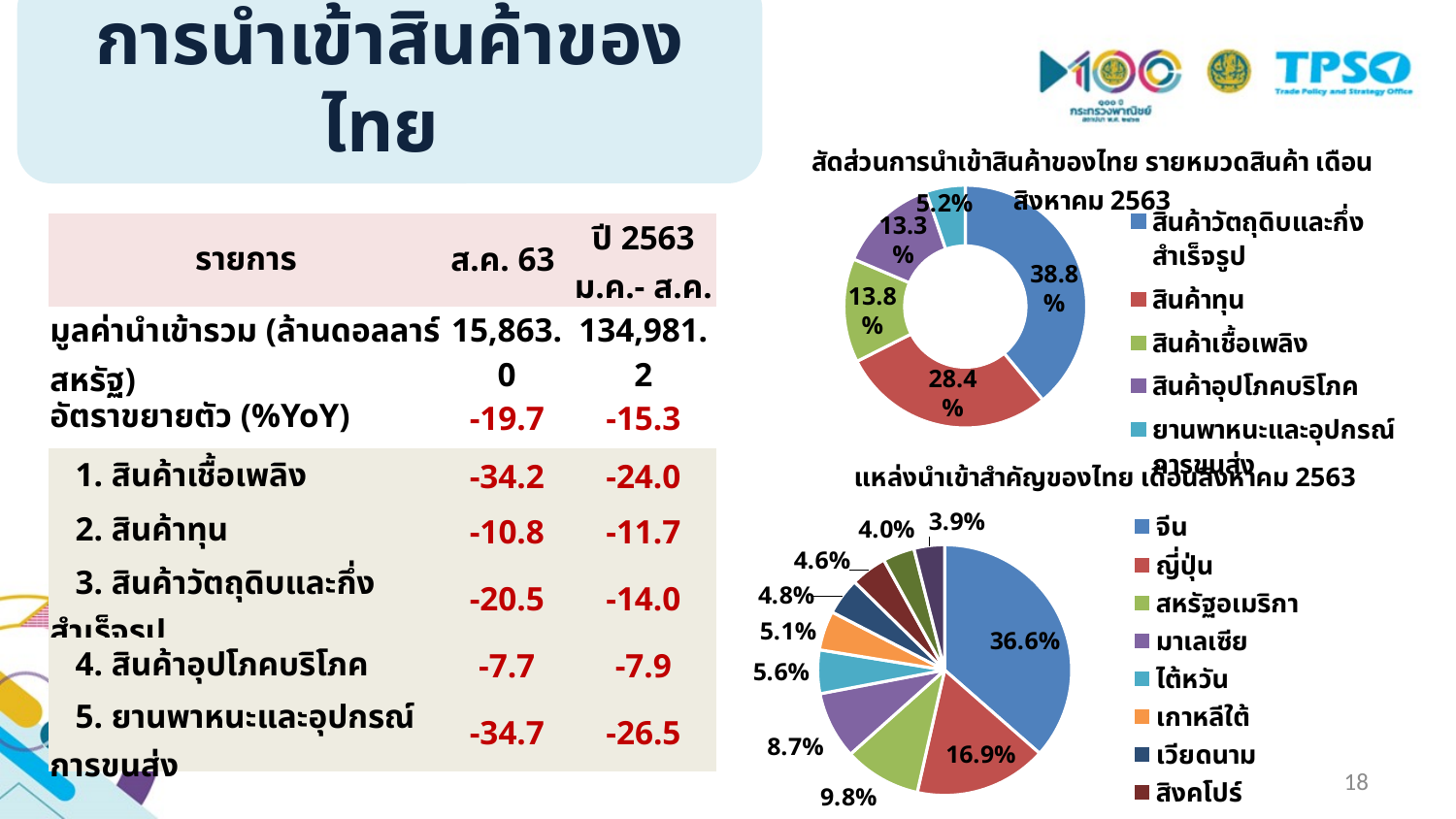
In the doughnut chart titled สัดส่วนการนำเข้าสินค้าของไทย รายหมวดสินค้า เดือนสิงหาคม 2563, which category has the largest share? สินค้าวัตถุดิบและกึ่งสำเร็จรูป In the doughnut chart titled สัดส่วนการนำเข้าสินค้าของไทย รายหมวดสินค้า เดือนสิงหาคม 2563, what is the difference in percentage points between สินค้าวัตถุดิบและกึ่งสำเร็จรูป and สินค้าทุน? 10.4 In the pie chart titled แหล่งนำเข้าสำคัญของไทย เดือนสิงหาคม 2563, which source has the largest share? จีน In the pie chart titled แหล่งนำเข้าสำคัญของไทย เดือนสิงหาคม 2563, what share does จีน have? 36.6% In the doughnut chart titled สัดส่วนการนำเข้าสินค้าของไทย รายหมวดสินค้า เดือนสิงหาคม 2563, what share does สินค้าทุน have? 28.4% What type of chart is the bottom-right chart titled แหล่งนำเข้าสำคัญของไทย เดือนสิงหาคม 2563? Pie chart In the pie chart titled แหล่งนำเข้าสำคัญของไทย เดือนสิงหาคม 2563, which is larger, the share for มาเลเซีย or the share for ไต้หวัน? มาเลเซีย In the pie chart titled แหล่งนำเข้าสำคัญของไทย เดือนสิงหาคม 2563, what share does ญี่ปุ่น have? 16.9% In the doughnut chart titled สัดส่วนการนำเข้าสินค้าของไทย รายหมวดสินค้า เดือนสิงหาคม 2563, what share does สินค้าวัตถุดิบและกึ่งสำเร็จรูป have? 38.8% In the doughnut chart titled สัดส่วนการนำเข้าสินค้าของไทย รายหมวดสินค้า เดือนสิงหาคม 2563, how many categories does the legend list? 5 In the doughnut chart titled สัดส่วนการนำเข้าสินค้าของไทย รายหมวดสินค้า เดือนสิงหาคม 2563, which category has the smallest share? ยานพาหนะและอุปกรณ์การขนส่ง In the pie chart titled แหล่งนำเข้าสำคัญของไทย เดือนสิงหาคม 2563, what share does สหรัฐอเมริกา have? 9.8%